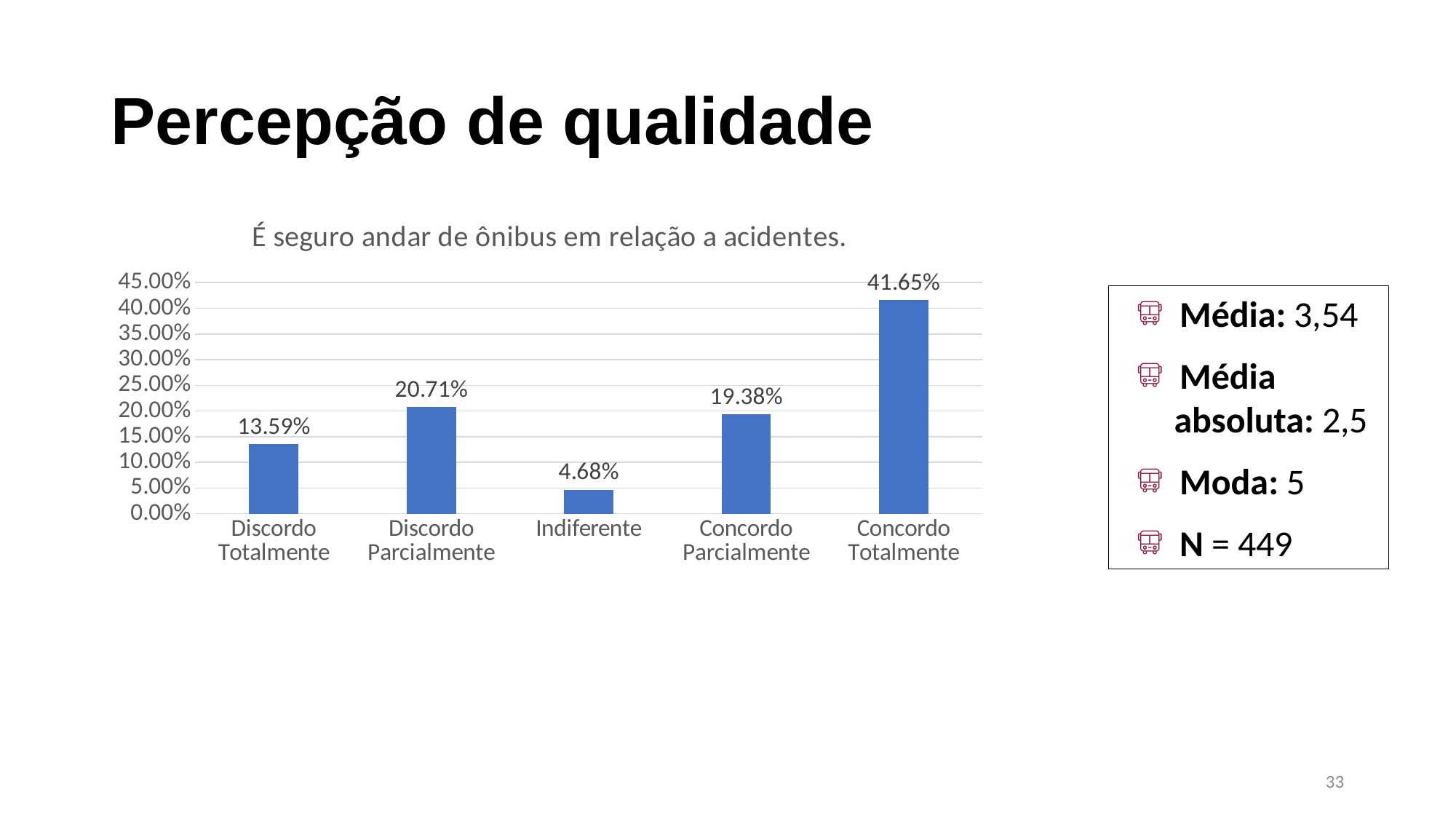
What is the difference between the values for Concordo Totalmente and Concordo Parcialmente? 22.27% Is the value for Concordo Totalmente greater or less than 40.00%? greater How many categories are shown on the x axis? 5 What is the value for Discordo Parcialmente? 20.71% What is the difference between the values for Discordo Parcialmente and Discordo Totalmente? 7.12% What kind of chart is shown on the slide? bar chart Which category has the lowest value? Indiferente Which is larger, the value for Discordo Totalmente or the value for Concordo Parcialmente? Concordo Parcialmente What is the value for Indiferente? 4.68% Which category has the highest value? Concordo Totalmente What is the title of the chart? É seguro andar de ônibus em relação a acidentes. What is the value for Concordo Totalmente? 41.65%